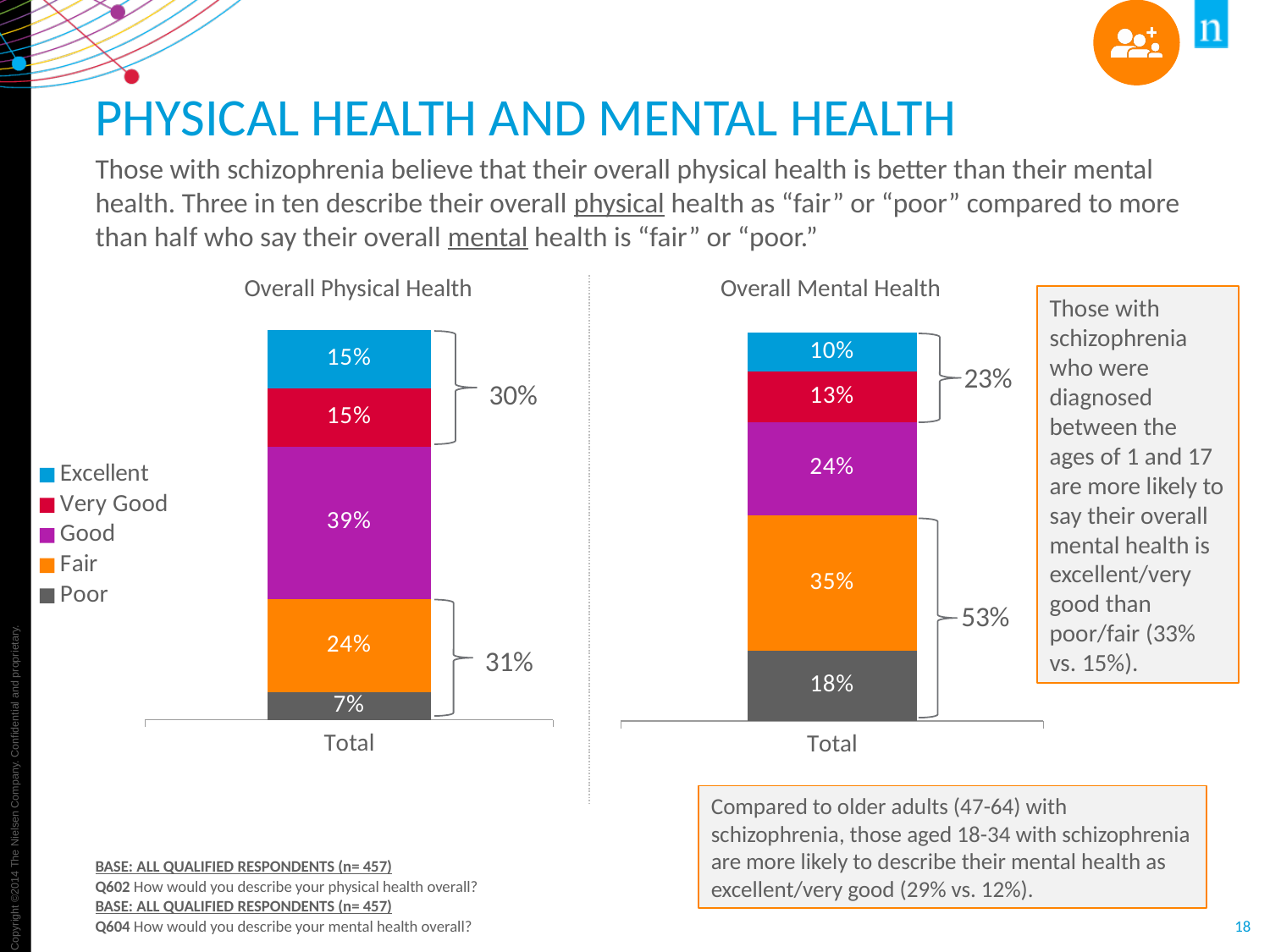
In the Overall Mental Health chart, which category has the largest share of the bar? Fair In the Overall Physical Health chart, which category has the smallest share of the bar? Poor In the Overall Mental Health chart, what percentage is shown for Poor? 18% In the Overall Physical Health chart, what percentage is shown for Poor? 7% What kind of chart is the Overall Mental Health chart? Stacked bar chart How many series does the legend list? 5 Which is larger: the Excellent percentage in the Overall Physical Health chart or the Excellent percentage in the Overall Mental Health chart? Overall Physical Health In the Overall Physical Health chart, what combined percentage is shown by the bracket for Excellent and Very Good? 30% In the Overall Mental Health chart, what percentage is shown for Fair? 35% What is the difference between the Good percentage in the Overall Physical Health chart and the Good percentage in the Overall Mental Health chart? 15% In the Overall Physical Health chart, what percentage is shown for Good? 39% In the Overall Mental Health chart, what combined percentage is shown by the bracket for Fair and Poor? 53%